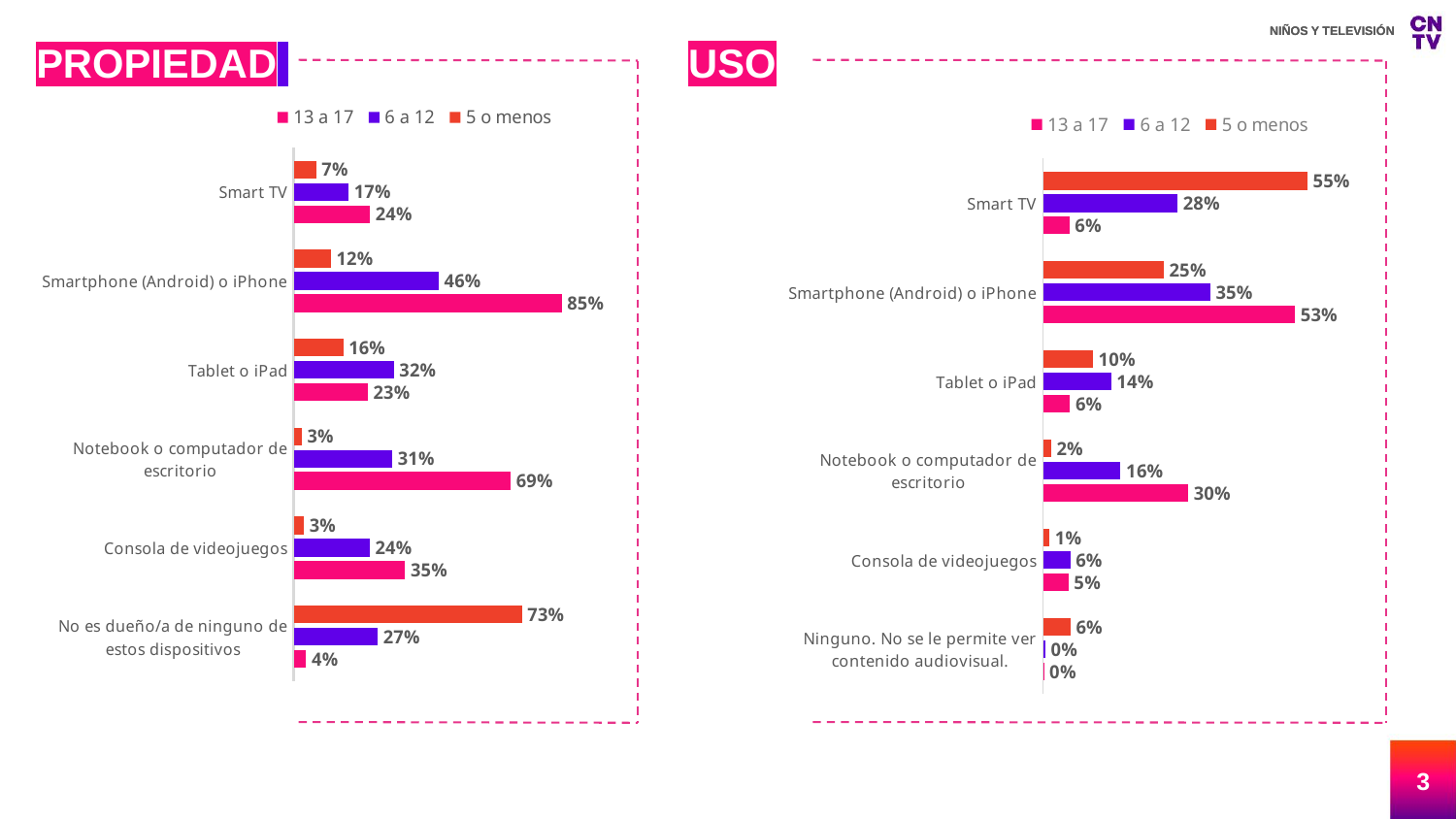
In the USO chart, what is the value for Smart TV in the 5 o menos series? 55% What are the three legend entries of the PROPIEDAD chart? 13 a 17, 6 a 12, 5 o menos In the USO chart, what is the value for Consola de videojuegos in the 13 a 17 series? 5% In the PROPIEDAD chart, what is the value for Smartphone (Android) o iPhone in the 13 a 17 series? 85% In the PROPIEDAD chart, which category has the highest value in the 5 o menos series? No es dueño/a de ninguno de estos dispositivos What kind of chart is the USO chart? Bar chart How many series does the legend of the USO chart list? 3 In the PROPIEDAD chart, what is the difference between the 13 a 17 and 6 a 12 values for Notebook o computador de escritorio? 38% How many categories does the PROPIEDAD chart show? 6 In the USO chart, which category has the lowest value in the 6 a 12 series? Ninguno. No se le permite ver contenido audiovisual. In the USO chart, which is larger for Tablet o iPad: the 6 a 12 value or the 5 o menos value? 6 a 12 In the PROPIEDAD chart, what is the difference between the 5 o menos and 13 a 17 values for No es dueño/a de ninguno de estos dispositivos? 69%